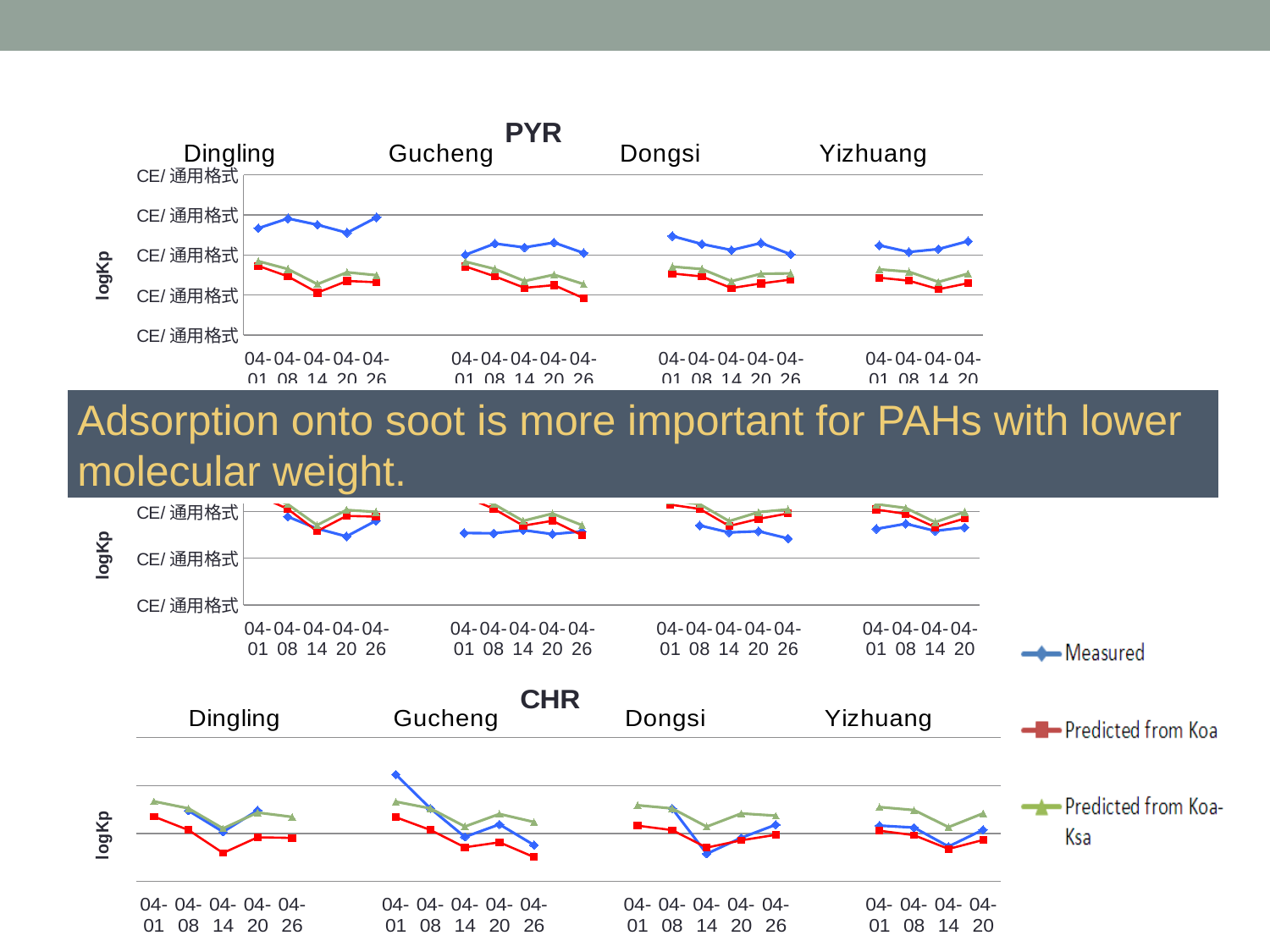
In the PYR chart, which series has the highest values at Dingling? Measured What kind of chart is the PYR chart at the top of the slide? Line chart What is the title of the top chart on the slide? PYR In the CHR chart, does the Measured series at Gucheng rise or fall from 04-01 to 04-14? Fall How many series does the legend list for the charts on this slide? 3 What are the three series named in the legend? Measured, Predicted from Koa, Predicted from Koa-Ksa In the PYR chart, how many dates are plotted for Dingling? 5 In the PYR chart, how many dates are plotted for Yizhuang? 4 In the PYR chart, how many sampling sites are shown along the x axis? 4 In the PYR chart at Dongsi, is the Measured series higher or lower than the Predicted from Koa series? Higher In the CHR chart, which series has the lowest values at Dingling? Predicted from Koa In the CHR chart, which series has the highest value at Gucheng on 04-01? Measured